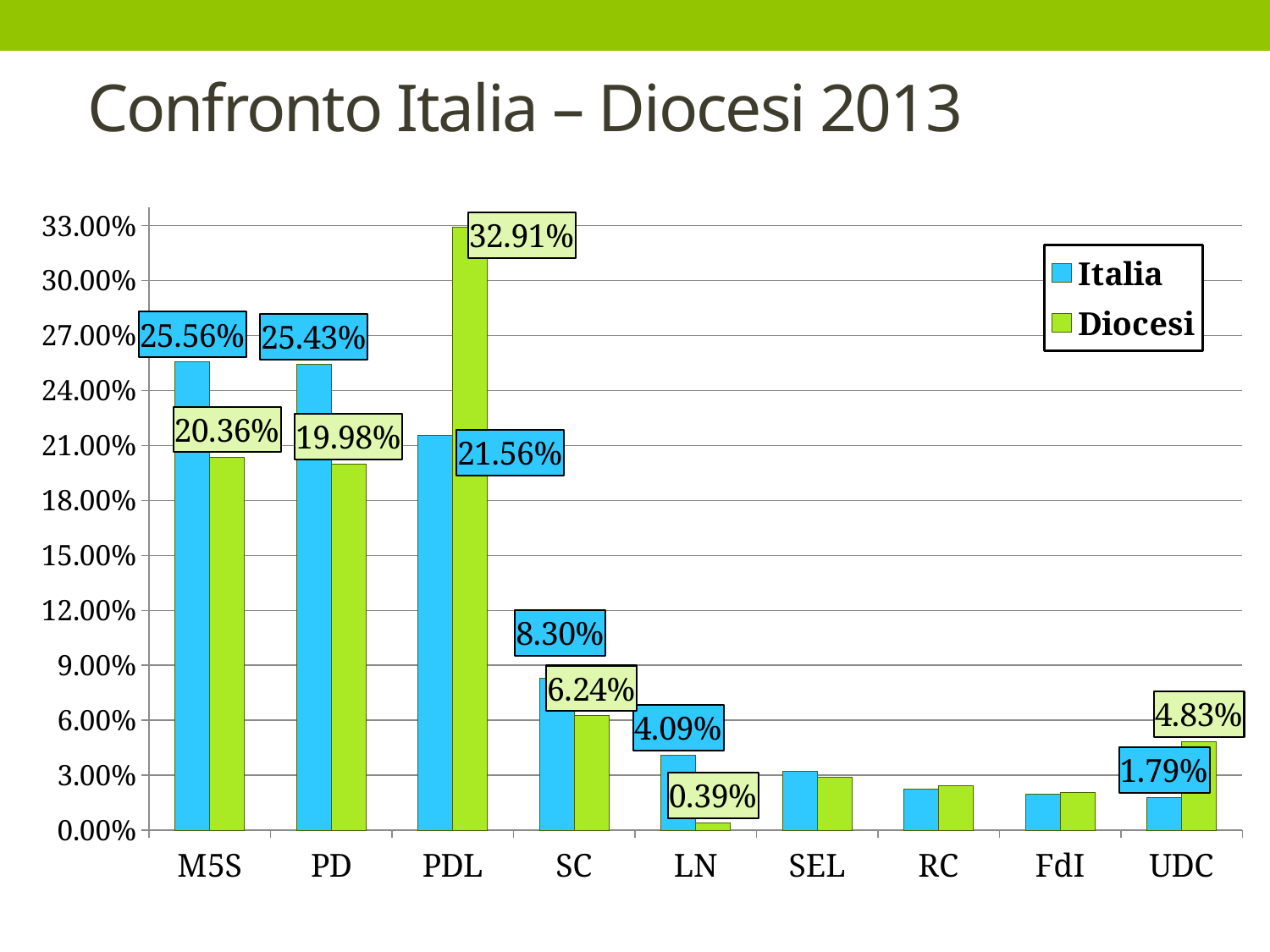
Which category has the lowest Diocesi value? LN What is the Diocesi value for LN? 0.39% What is the Italia value for UDC? 1.79% Is the Italia value for SEL greater or less than 6.00%? less How many series does the legend list? 2 For SC, which is larger: the Italia value or the Diocesi value? Italia How many categories are shown on the x axis? 9 What kind of chart is shown on the slide? bar chart Which category has the highest Diocesi value? PDL What is the difference between the Diocesi and Italia values for PDL? 11.35% What is the Italia value for M5S? 25.56% What is the Diocesi value for PDL? 32.91%